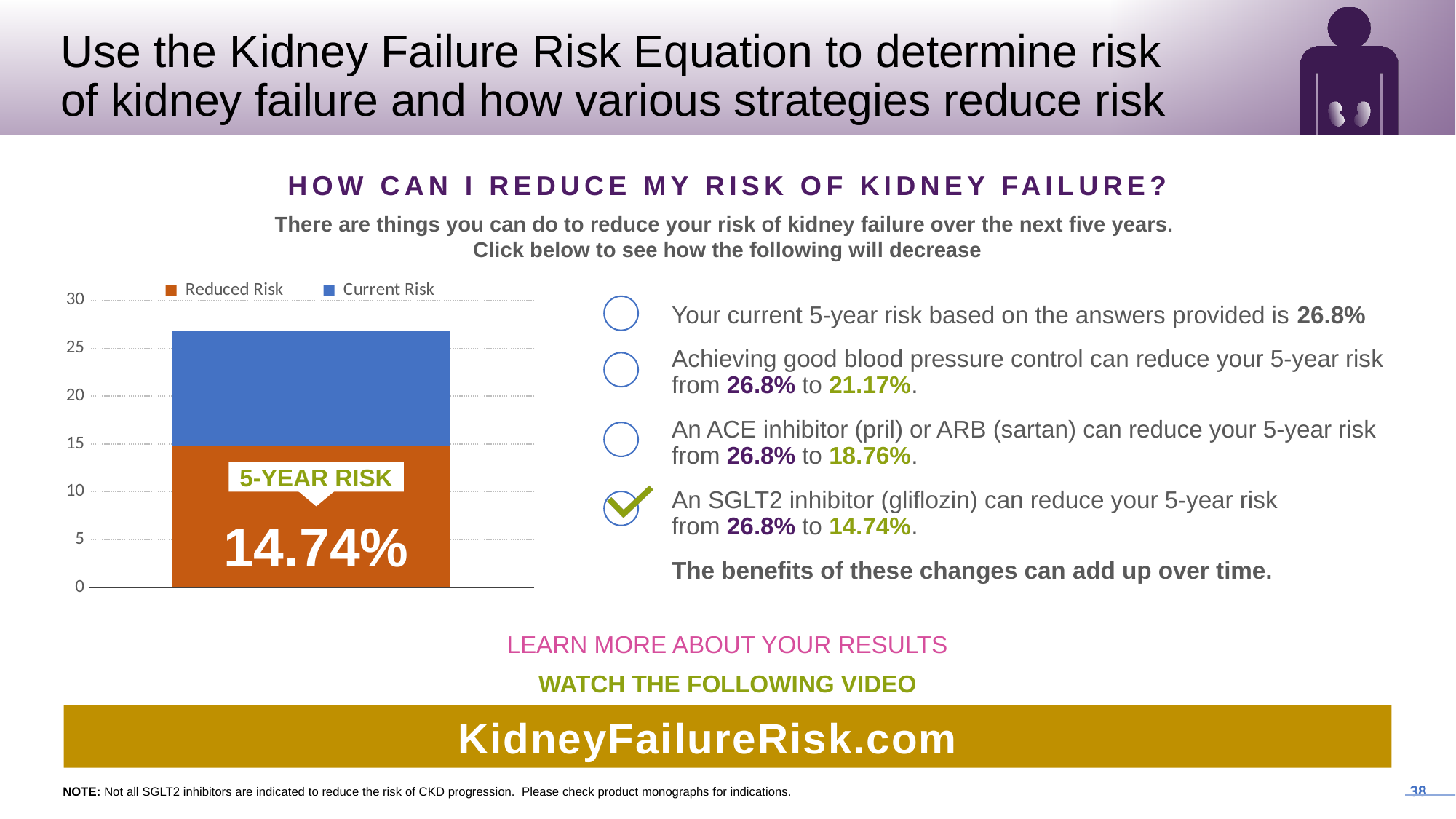
What text appears in the callout label above the printed value on the bar? 5-YEAR RISK Is the Reduced Risk segment greater or less than 10 on the y axis? greater Is the top of the Current Risk (blue) segment greater or less than 20 on the y axis? greater What kind of chart is shown on the slide? Stacked bar chart How many series does the chart legend list? 2 What are the two entries in the chart legend? Reduced Risk and Current Risk Which segment of the bar is taller, the Reduced Risk (orange) segment or the Current Risk (blue) segment? Reduced Risk What value is printed on the Reduced Risk (orange) segment of the bar? 14.74% How many stacked bars are plotted in the chart? 1 Is the top of the full stacked bar greater or less than 25 on the y axis? greater